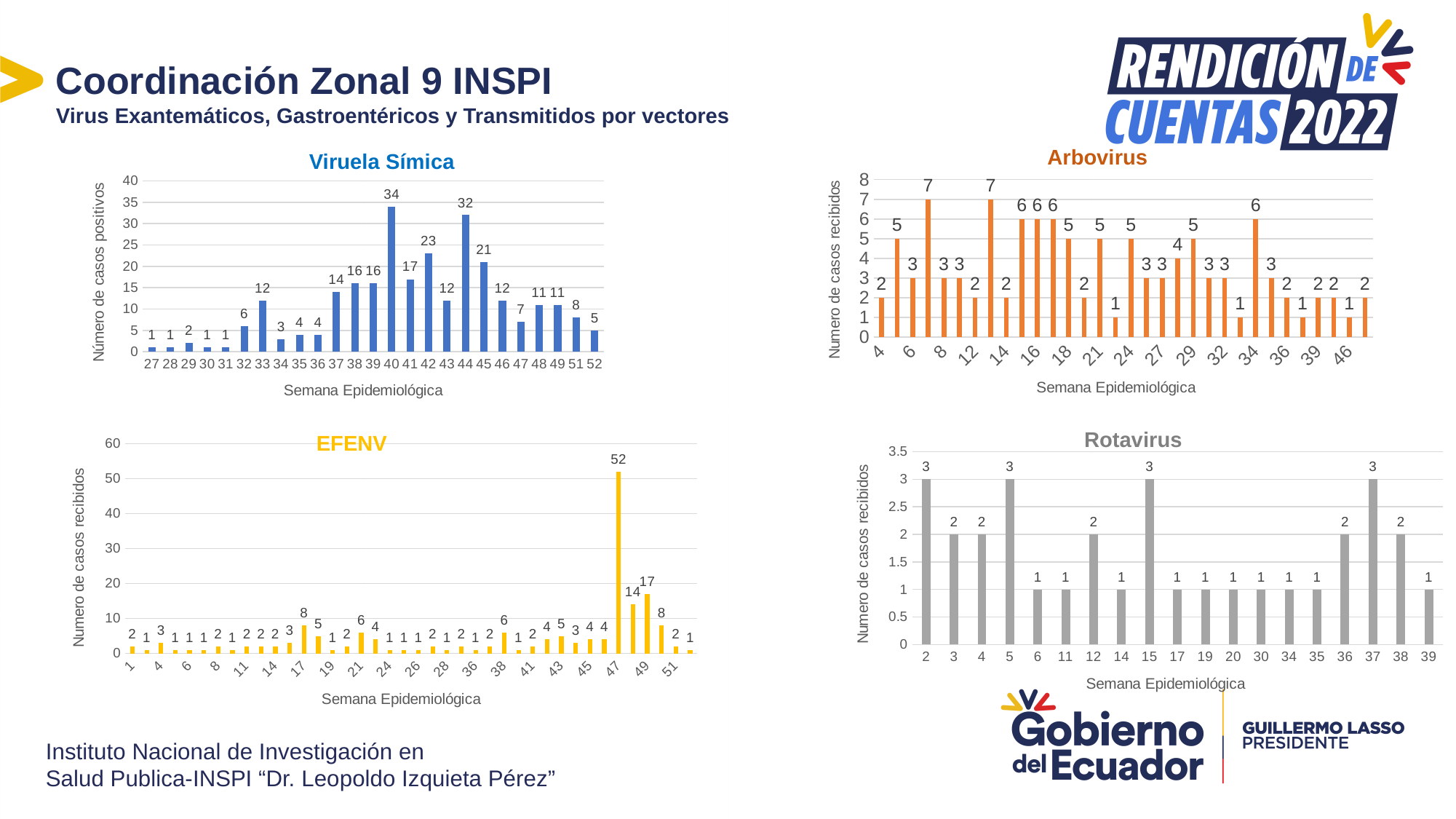
In the Viruela Símica chart, what is the value for week 44? 32 In the Viruela Símica chart, which epidemiological week has the highest number of positive cases? 40 In the EFENV chart, what is the value for week 47? 52 In the Viruela Símica chart, how many epidemiological weeks (bars) are plotted? 25 What kind of chart is the Arbovirus chart? bar chart In the Viruela Símica chart, which has the larger value, week 41 or week 42? 42 In the EFENV chart, which epidemiological week has the highest number of cases received? 47 In the Arbovirus chart, what is the highest number of cases received in any week? 7 In the Rotavirus chart, what is the number of cases received in week 2? 3 In the Viruela Símica chart, what is the difference between the values for week 40 and week 44? 2 In the Rotavirus chart, how many epidemiological weeks (bars) are plotted? 19 In the Viruela Símica chart, what is the number of positive cases in epidemiological week 40? 34